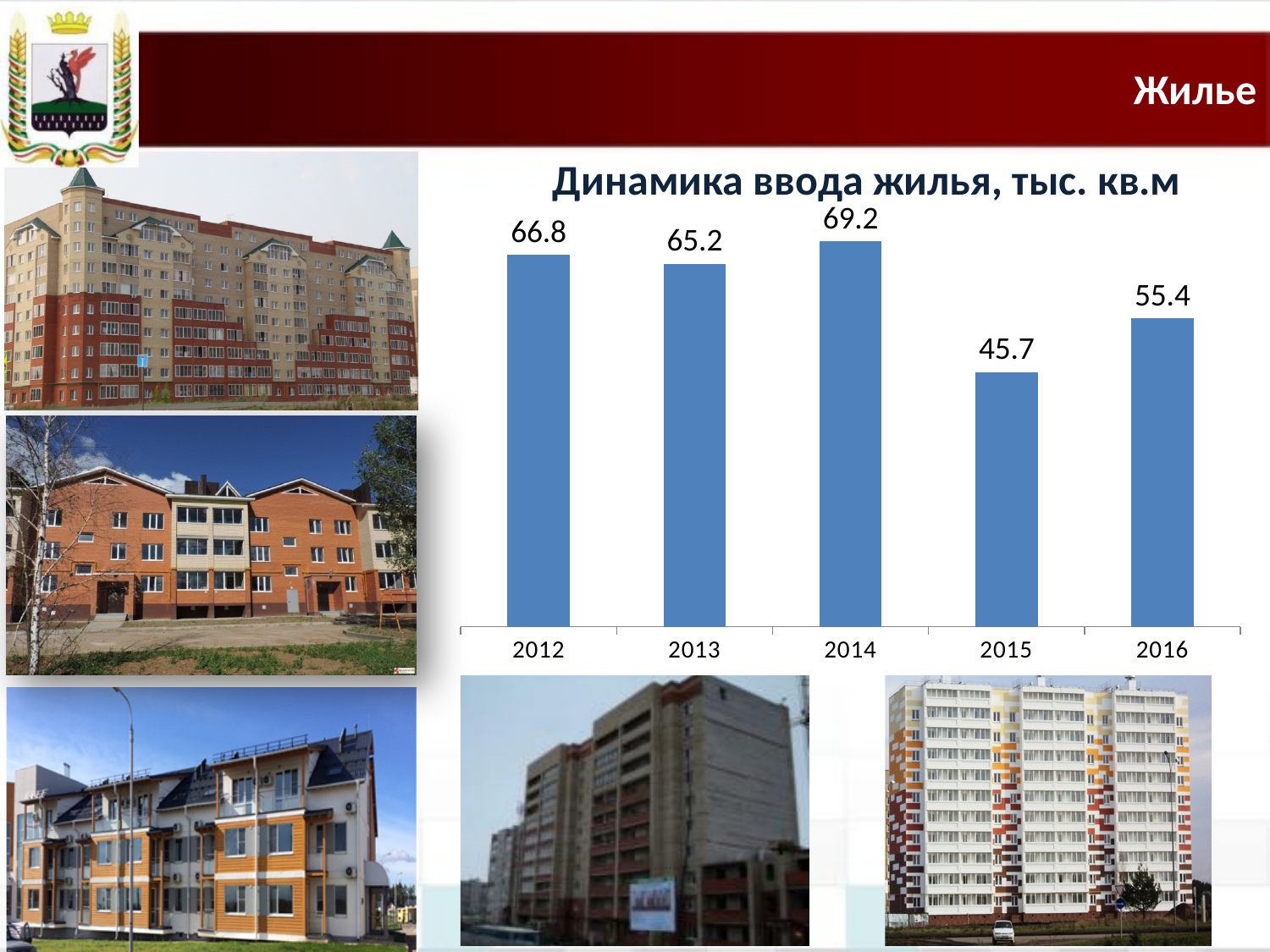
How many years are shown on the chart? 5 What is the value for 2012? 66.8 What is the title of the chart? Динамика ввода жилья, тыс. кв.м What is the difference between the values for 2012 and 2013? 1.6 What is the value for 2015? 45.7 Do the values rise or fall from 2014 to 2015? fall What kind of chart is shown on the slide? bar chart Which year has the lowest value? 2015 Which is larger, the value for 2013 or the value for 2016? 2013 What is the value for 2016? 55.4 Which year has the highest value? 2014 What is the difference between the values for 2014 and 2015? 23.5